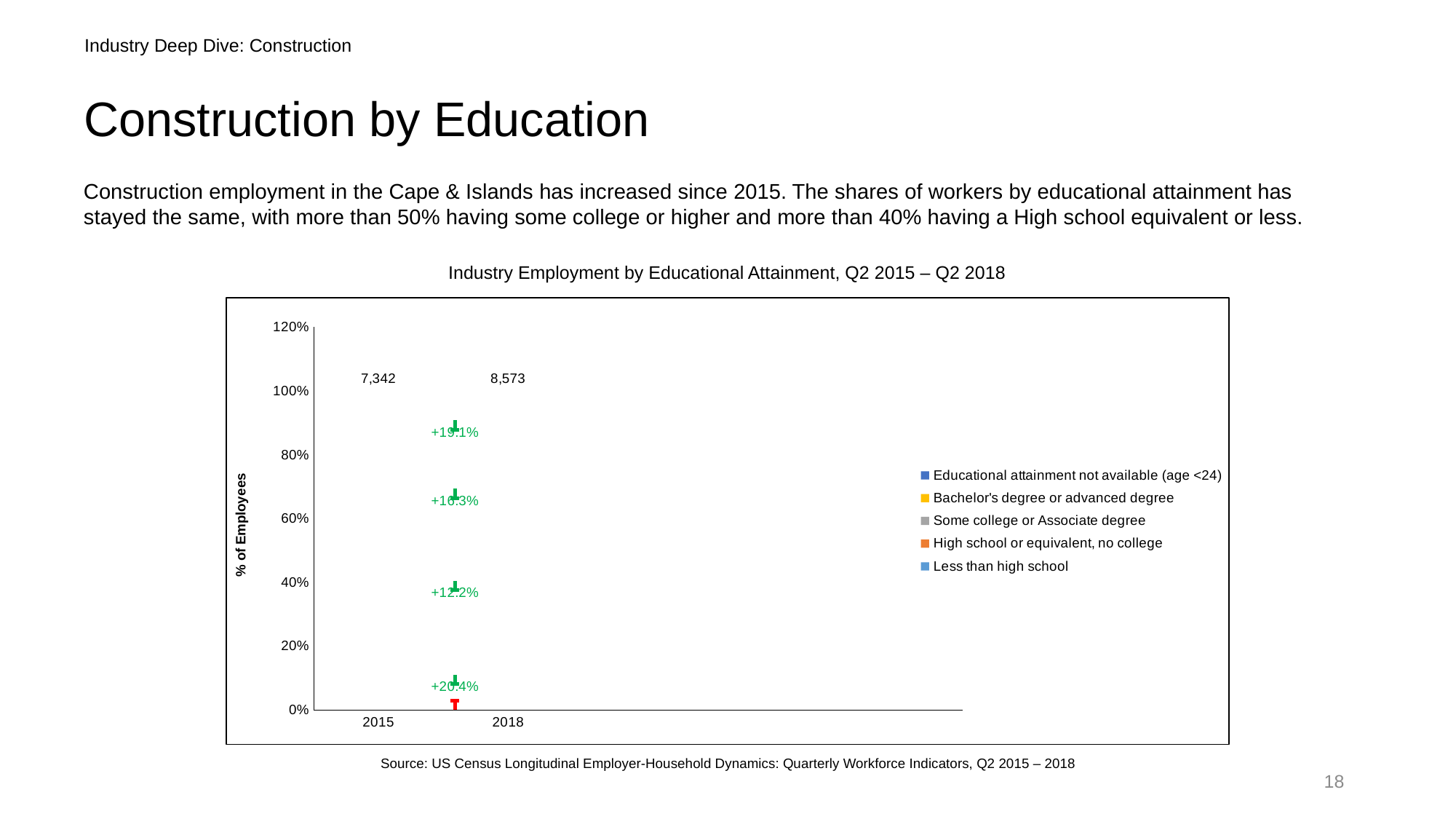
What is the total employment figure printed above the 2018 bar? 8,573 What is the title of the chart? Industry Employment by Educational Attainment, Q2 2015 – Q2 2018 What is the smallest percentage change annotated in green on the chart? +12.2% What is the label on the y axis of the chart? % of Employees What is the total employment figure printed above the 2015 bar? 7,342 What is the largest percentage change annotated in green on the chart? +20.4% Which year has the larger total employment figure printed on the chart, 2015 or 2018? 2018 What is the difference between the total employment figures printed for 2018 and 2015? 1,231 What is the highest value shown on the y axis of the chart? 120% How many years are shown on the x axis of the chart? 2 How many series does the chart legend list? 5